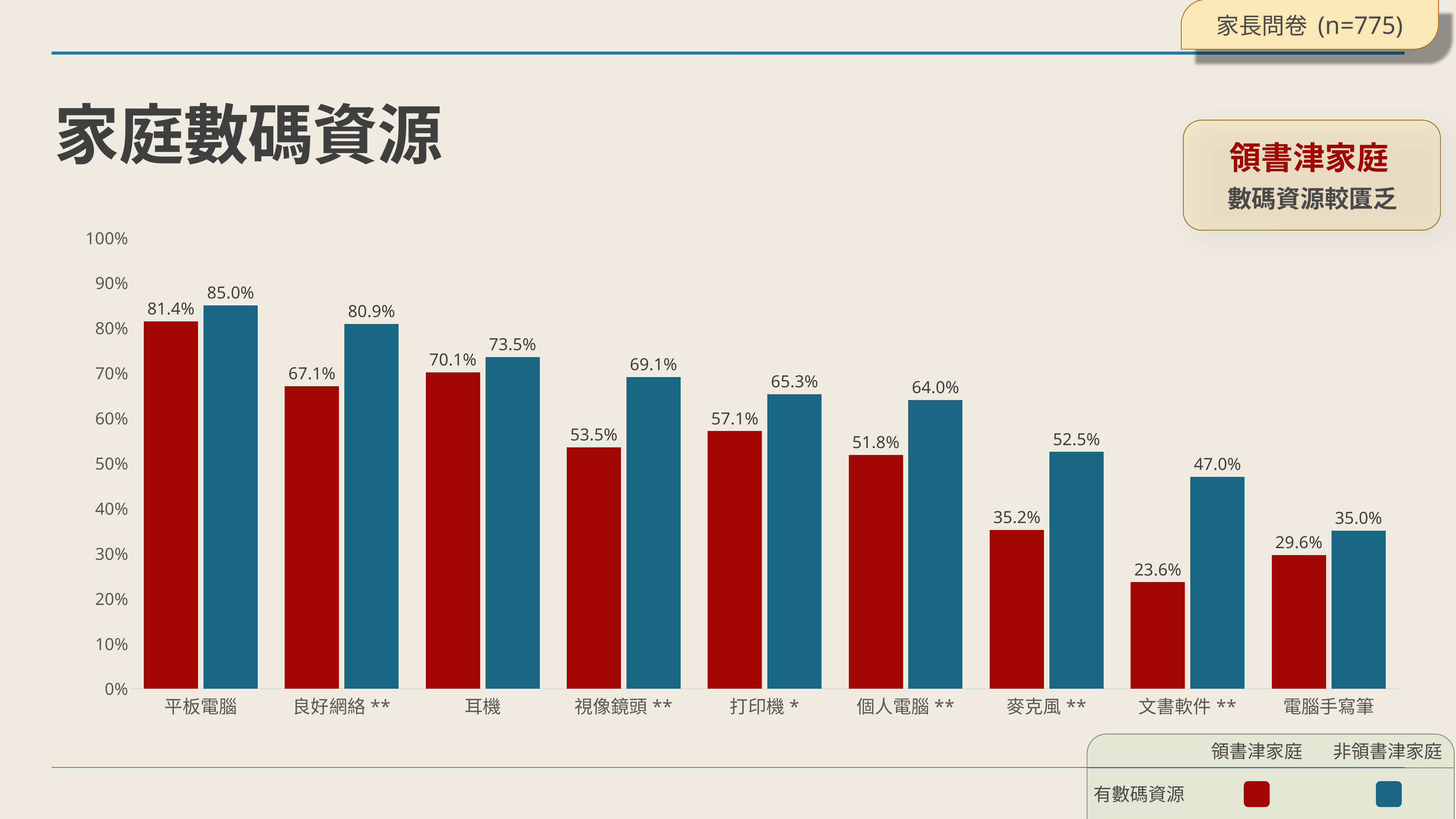
How many categories are shown on the x axis? 9 What is the difference between 非領書津家庭 and 領書津家庭 for 良好網絡 **? 13.8% What is the value for 領書津家庭 for 平板電腦? 81.4% What is the value for 領書津家庭 for 麥克風 **? 35.2% Which category has the lowest value for 領書津家庭? 文書軟件 ** Which colour represents 領書津家庭 in the chart? Red What kind of chart is shown on the slide? Bar chart Which category has the highest value for 非領書津家庭? 平板電腦 What is the value for 非領書津家庭 for 文書軟件 **? 47.0% Which is larger for 視像鏡頭 **: 領書津家庭 or 非領書津家庭? 非領書津家庭 How many series does the legend list? 2 What is the difference between 非領書津家庭 and 領書津家庭 for 文書軟件 **? 23.4%